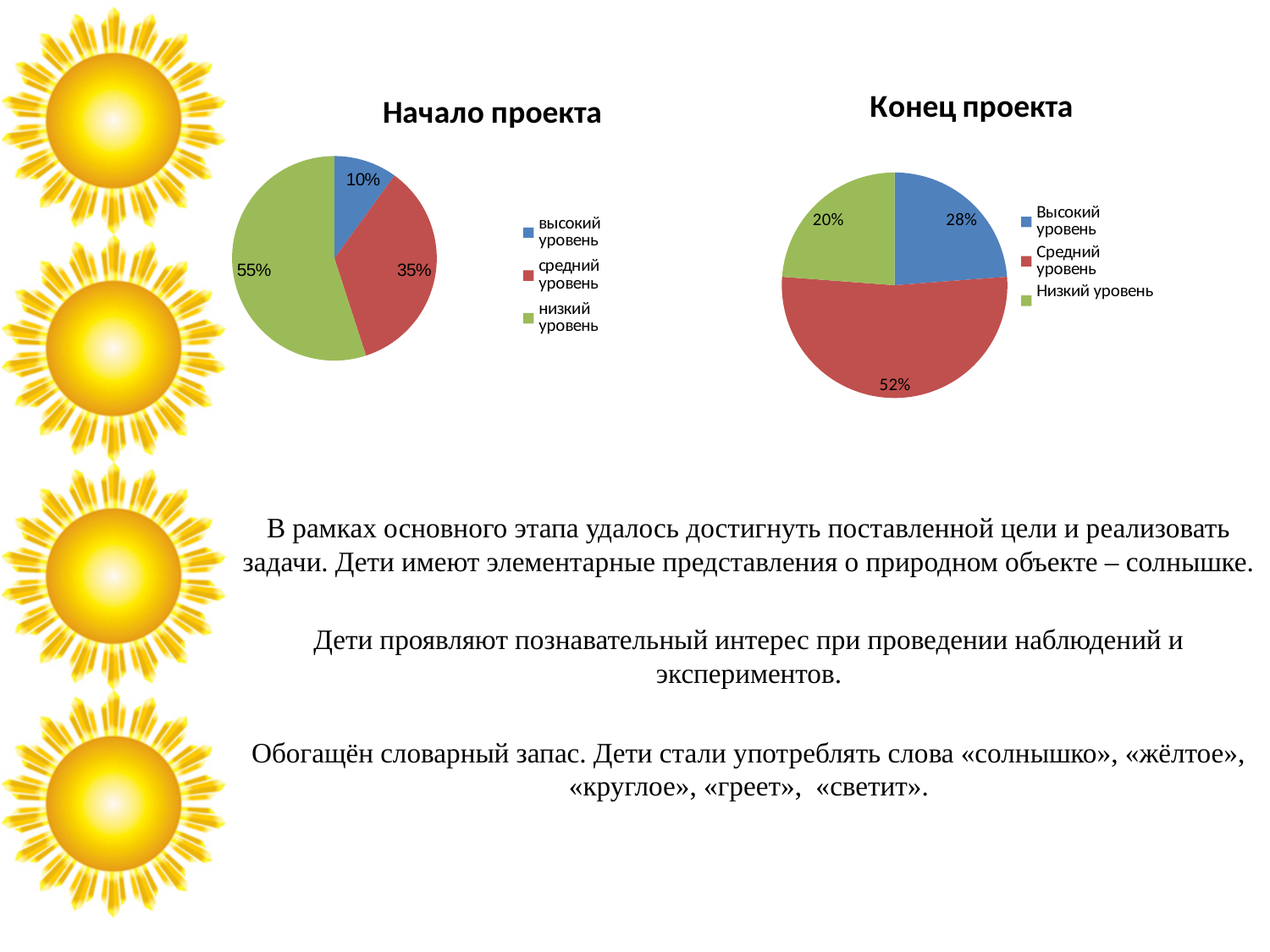
How many slices does the "Конец проекта" chart have? 3 In the "Конец проекта" chart, what is the difference between "Средний уровень" and "Высокий уровень"? 24% In the "Конец проекта" chart, what colour is the "Средний уровень" slice? Red In the "Конец проекта" chart, which category has the smallest slice? Низкий уровень How many entries does the legend of the "Начало проекта" chart list? 3 What type of chart is the "Начало проекта" chart? Pie chart In the "Начало проекта" chart, what is the value for "высокий уровень"? 10% In the "Начало проекта" chart, which category has the largest slice? низкий уровень In the "Конец проекта" chart, which is larger: "Высокий уровень" or "Низкий уровень"? Высокий уровень In the "Начало проекта" chart, what is the difference between "низкий уровень" and "средний уровень"? 20% In the "Конец проекта" chart, what is the value for "Средний уровень"? 52% In the "Начало проекта" chart, what is the value for "низкий уровень"? 55%